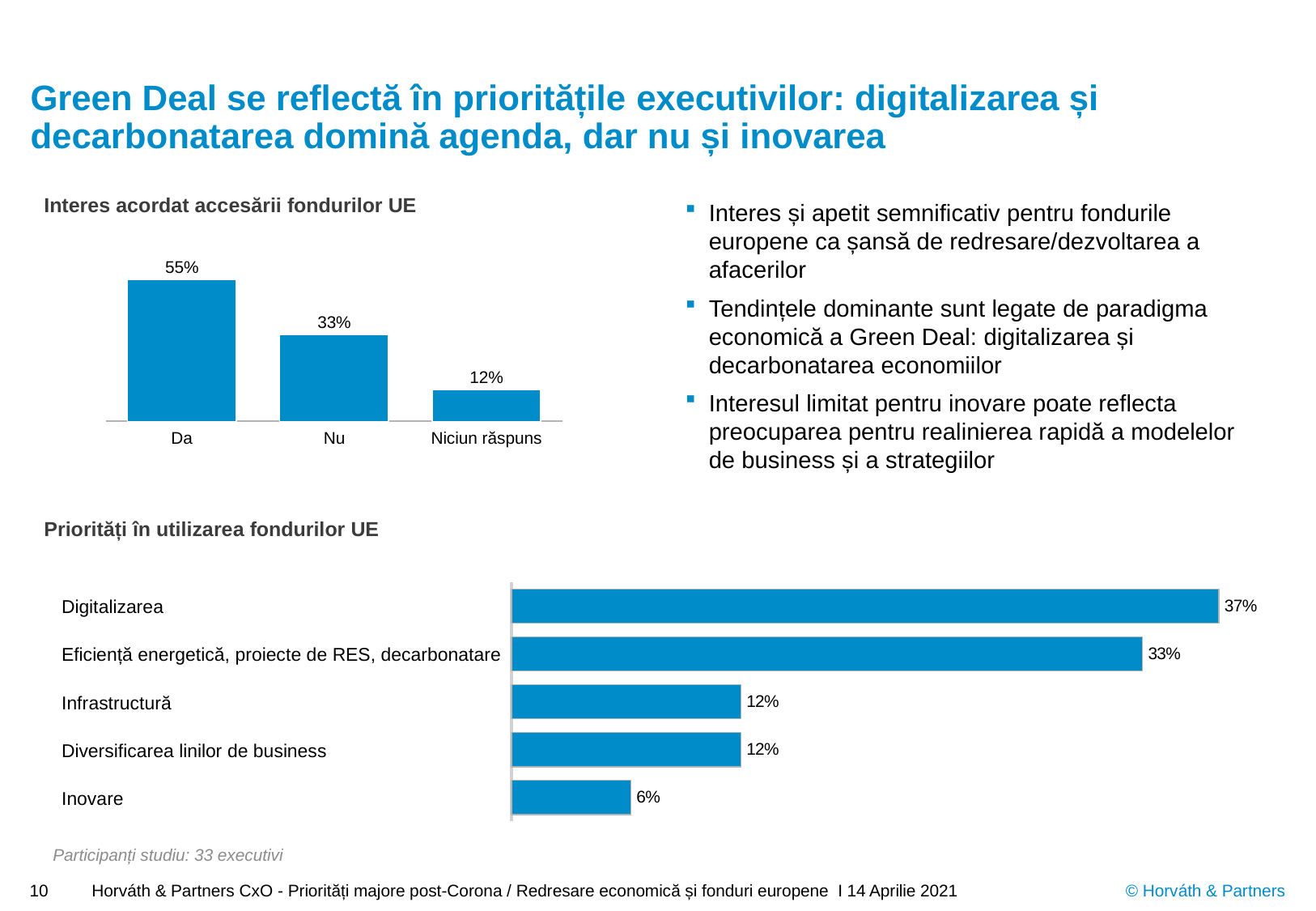
In the chart 'Priorități în utilizarea fondurilor UE', how many categories are shown? 5 In the chart 'Interes acordat accesării fondurilor UE', what kind of chart is used? Bar chart In the chart 'Priorități în utilizarea fondurilor UE', what is the value for 'Diversificarea linilor de business'? 12% In the chart 'Interes acordat accesării fondurilor UE', what is the value for 'Da'? 55% In the chart 'Interes acordat accesării fondurilor UE', how many categories are shown? 3 In the chart 'Priorități în utilizarea fondurilor UE', what is the value for 'Digitalizarea'? 37% In the chart 'Interes acordat accesării fondurilor UE', what is the difference between the values for 'Da' and 'Nu'? 22% In the chart 'Priorități în utilizarea fondurilor UE', which is larger: 'Eficiență energetică, proiecte de RES, decarbonatare' or 'Infrastructură'? Eficiență energetică, proiecte de RES, decarbonatare In the chart 'Interes acordat accesării fondurilor UE', which category has the lowest value? Niciun răspuns In the chart 'Priorități în utilizarea fondurilor UE', what is the value for 'Inovare'? 6% In the chart 'Priorități în utilizarea fondurilor UE', what is the difference between 'Digitalizarea' and 'Inovare'? 31% In the chart 'Priorități în utilizarea fondurilor UE', which category has the highest value? Digitalizarea